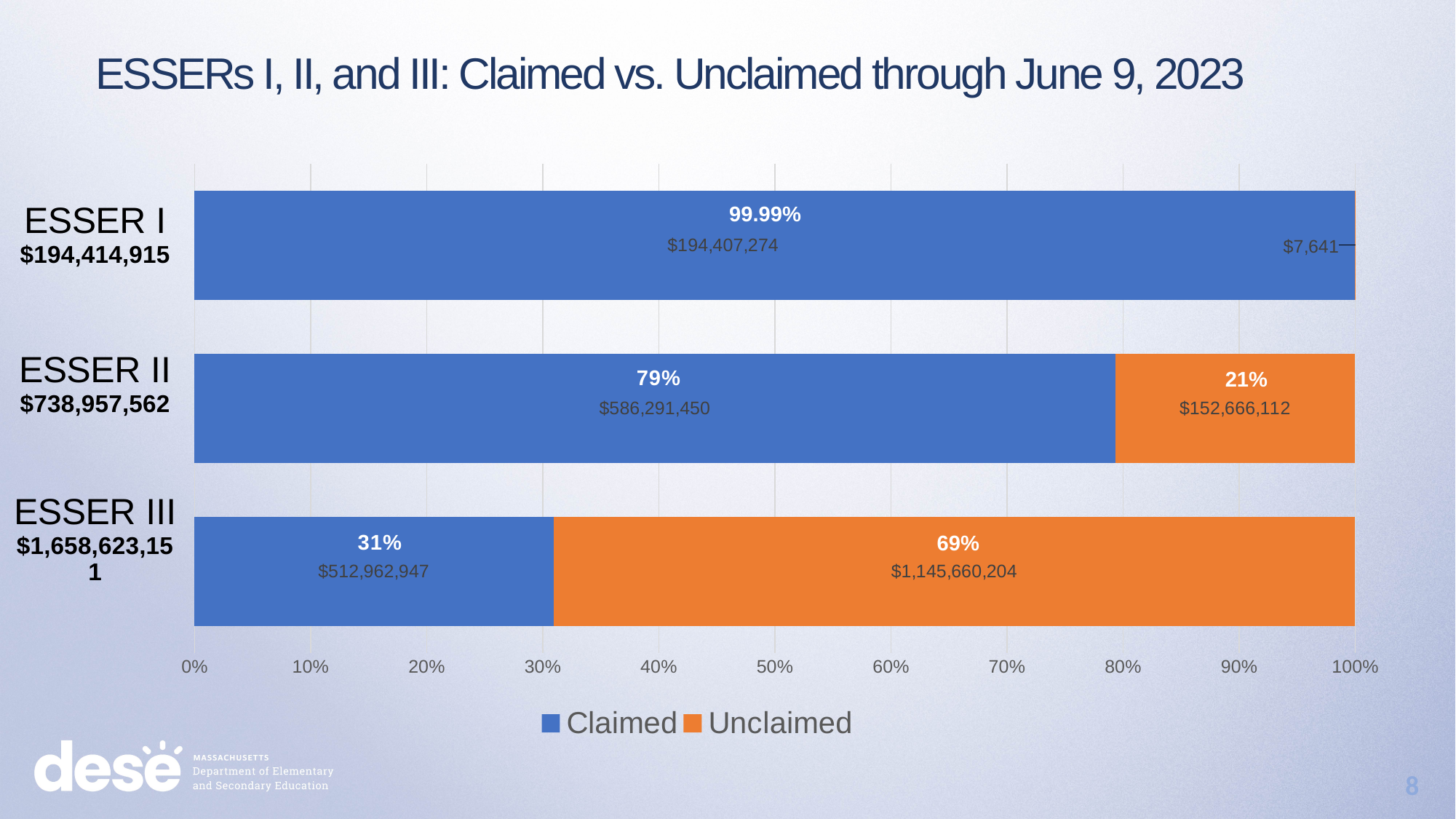
Which ESSER program has the lowest Claimed percentage? ESSER III How many series does the legend list? 2 Is the Claimed share for ESSER III greater or less than 40%? less What dollar amount is shown as Unclaimed for ESSER I? $7,641 Which is larger for ESSER II: the Claimed share or the Unclaimed share? Claimed What percentage of ESSER III funds is shown as Claimed? 31% What kind of chart is shown on the slide? Stacked bar chart How many ESSER programs are shown on the chart? 3 What is the difference in percentage points between the Claimed shares of ESSER II and ESSER III? 48 Which ESSER program has the highest Claimed percentage? ESSER I What dollar amount is shown as Unclaimed for ESSER III? $1,145,660,204 What percentage of ESSER II funds is shown as Claimed? 79%